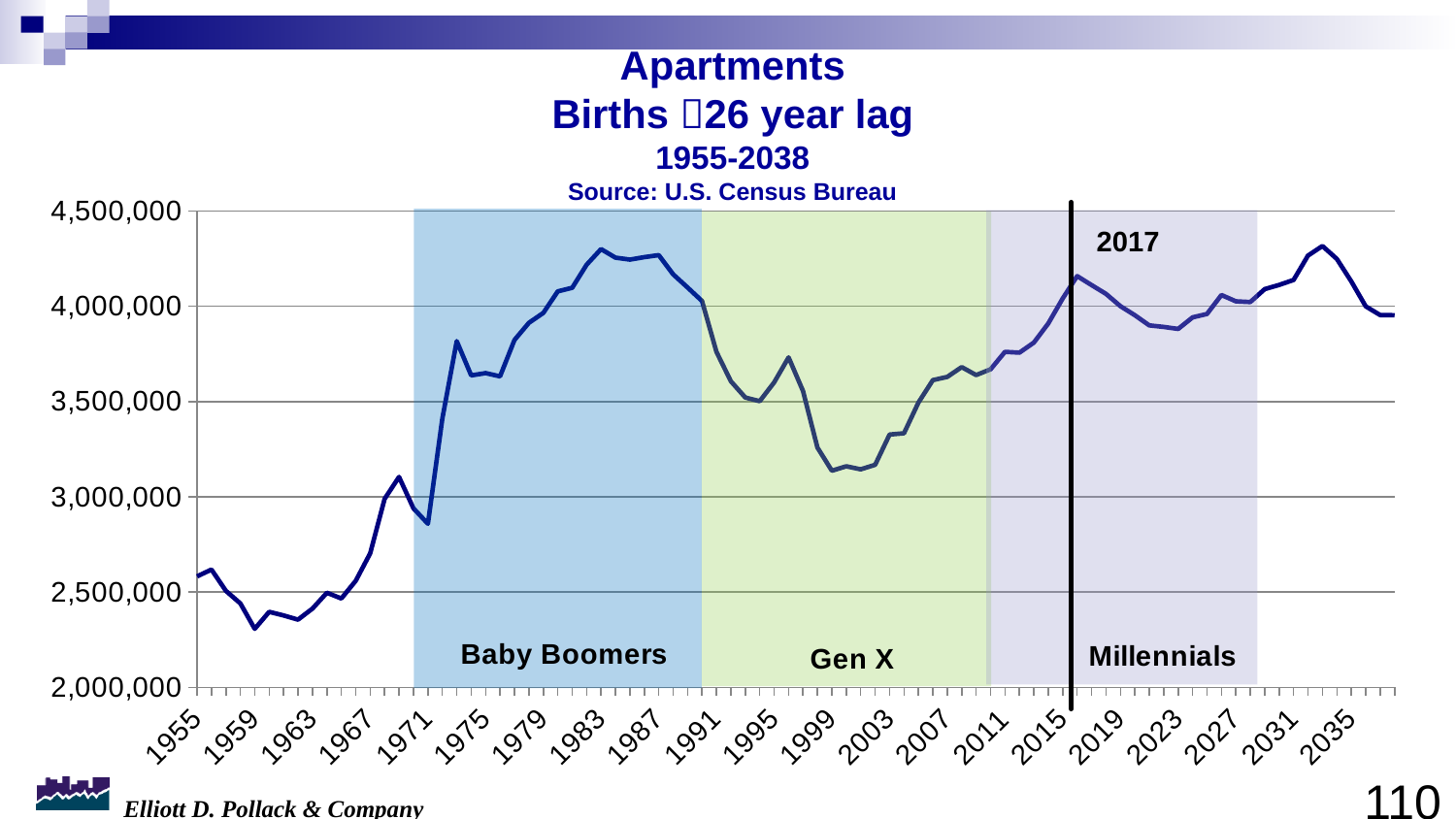
Which generation label is shown in the blue shaded region of the chart? Baby Boomers Do the values rise or fall between 1987 and 1999? fall What kind of chart is shown on the slide? line chart What year is marked by the vertical black line on the chart? 2017 Is the value for 2035 greater or less than 4,000,000? greater Which year has the larger value, 1983 or 2001? 1983 Which year has the larger value, 1959 or 2017? 2017 Is the value for 1959 greater or less than 2,500,000? less Do the values rise or fall between 1999 and 2011? rise Is the value for 2001 greater or less than 3,500,000? less